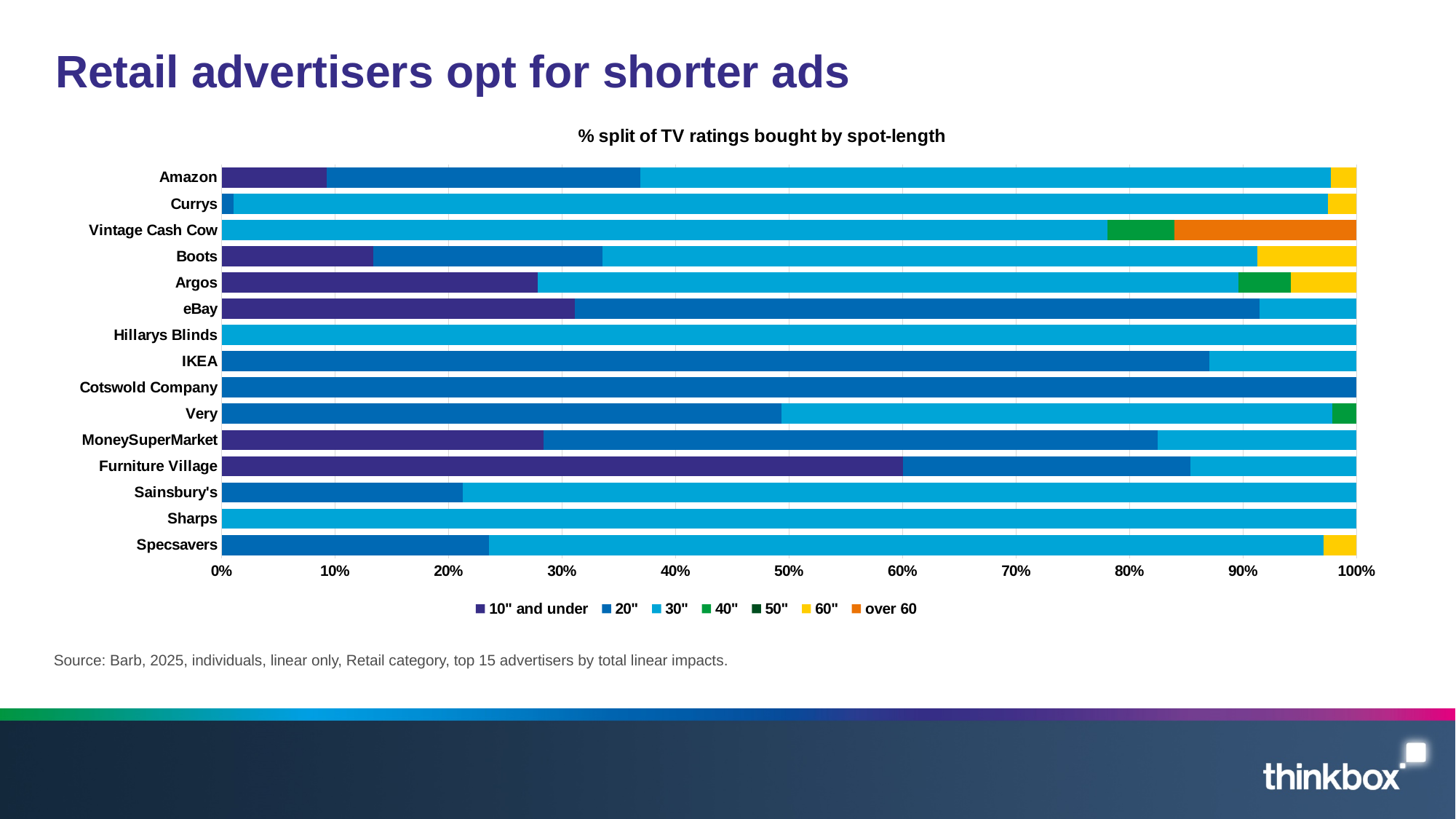
What is the title of the chart? % split of TV ratings bought by spot-length Is Boots's share of ratings at 10" and under greater or less than 10%? greater Which advertiser bought 100% of its ratings at 20" spot-length? Cotswold Company Which advertiser is the only one with ratings bought at over 60 seconds? Vintage Cash Cow What kind of chart is shown on the slide? Stacked bar chart Which has the larger share of ratings at 10" and under, Amazon or Currys? Amazon Is Furniture Village's share of ratings at 10" and under greater or less than 50%? greater Which has the larger share of ratings at 10" and under, Argos or Boots? Argos How many spot-length series does the legend list? 7 Is Argos's share of ratings at 10" and under greater or less than 30%? less How many advertisers are listed on the chart? 15 Which advertiser has the largest share of ratings bought at 10" and under? Furniture Village